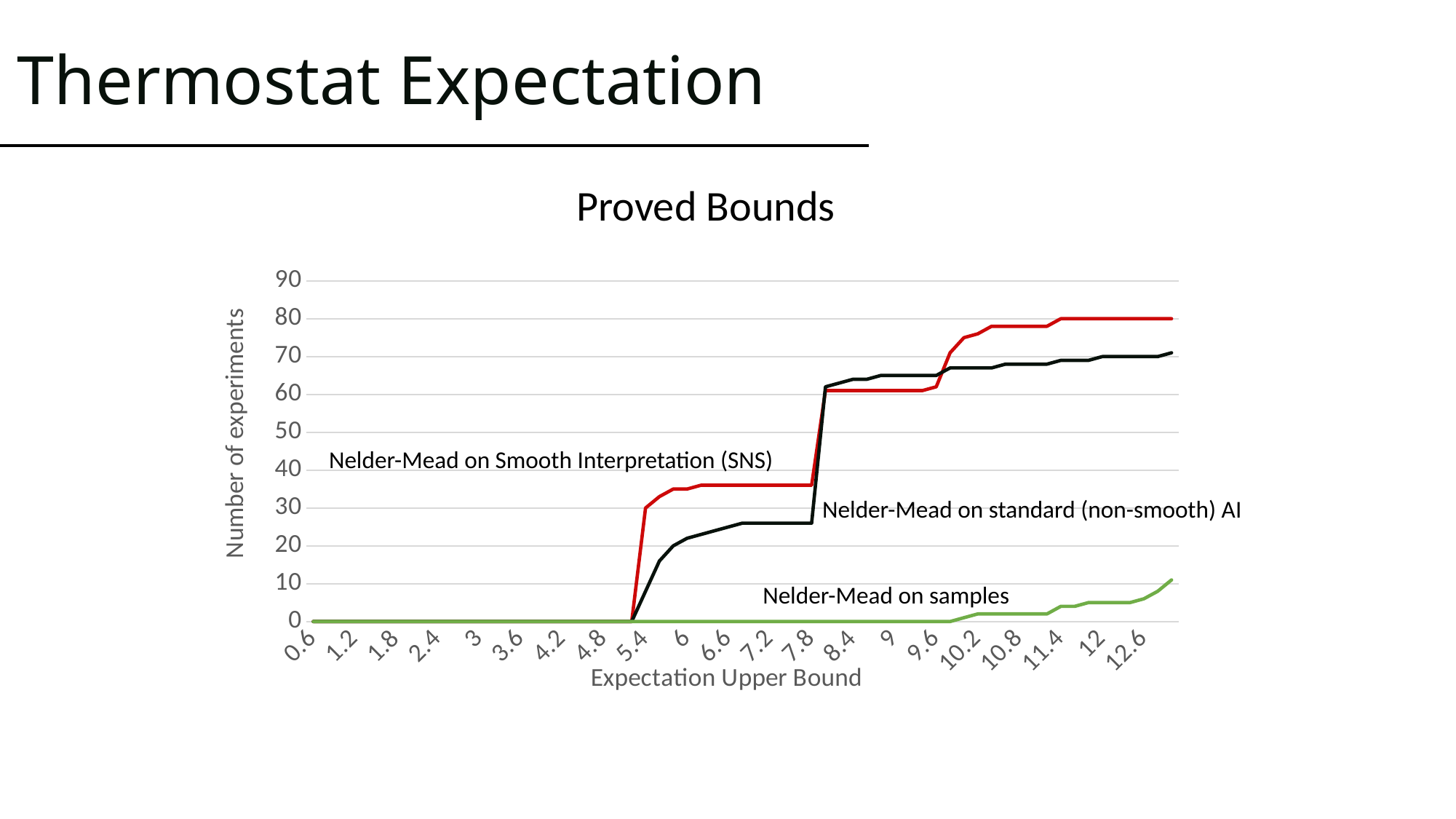
Is the value for Nelder-Mead on Smooth Interpretation (SNS) at an expectation upper bound of 12.6 greater or less than 70? greater Is the value for Nelder-Mead on standard (non-smooth) AI at an expectation upper bound of 6.6 greater or less than 30? less Is the value for Nelder-Mead on Smooth Interpretation (SNS) at an expectation upper bound of 6.6 greater or less than 30? greater What is the label of the x axis? Expectation Upper Bound How many series are plotted in the chart? 3 What is the title of the chart? Proved Bounds Which series has the lowest value at an expectation upper bound of 12.6? Nelder-Mead on samples At an expectation upper bound of 12.6, which series has the higher value: Nelder-Mead on Smooth Interpretation (SNS) or Nelder-Mead on standard (non-smooth) AI? Nelder-Mead on Smooth Interpretation (SNS) What kind of chart is shown on the slide? line chart Does the Nelder-Mead on Smooth Interpretation (SNS) line rise or fall as the expectation upper bound increases? rise